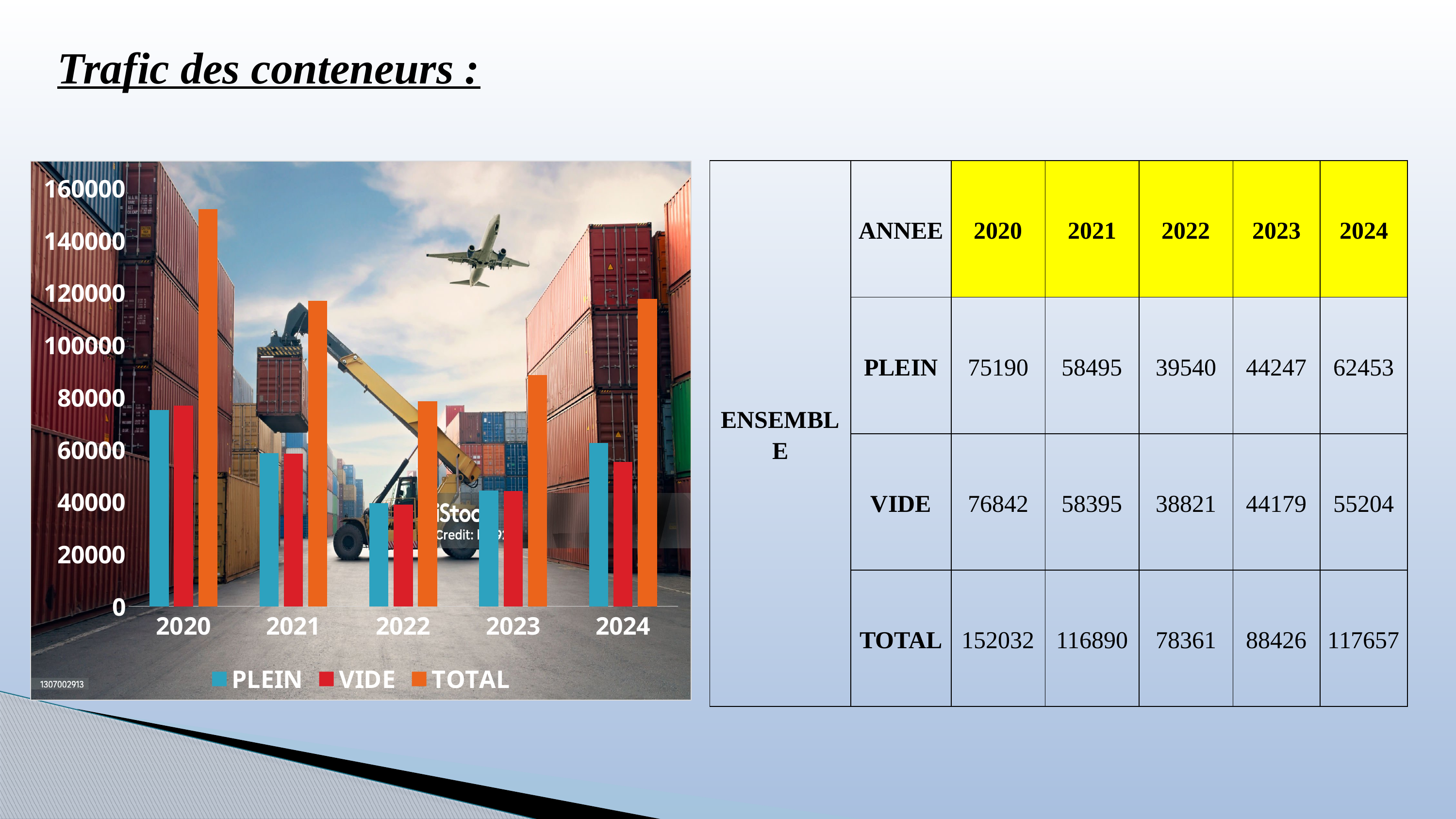
Which year has the lowest TOTAL bar? 2022 Which colour represents the TOTAL series in the chart legend? orange Does the TOTAL series rise or fall from 2020 to 2022? fall How many years are shown on the x axis of the chart? 5 Is the TOTAL value for 2020 greater or less than 140000? greater Is the PLEIN value for 2022 greater or less than 40000? less How many series does the chart legend list? 3 Which is larger, the PLEIN bar for 2024 or the VIDE bar for 2024? PLEIN Which is larger, the TOTAL bar for 2021 or the TOTAL bar for 2023? 2021 Is the TOTAL value for 2023 greater or less than 100000? less Which year has the highest TOTAL bar? 2020 What kind of chart is shown on the slide? bar chart